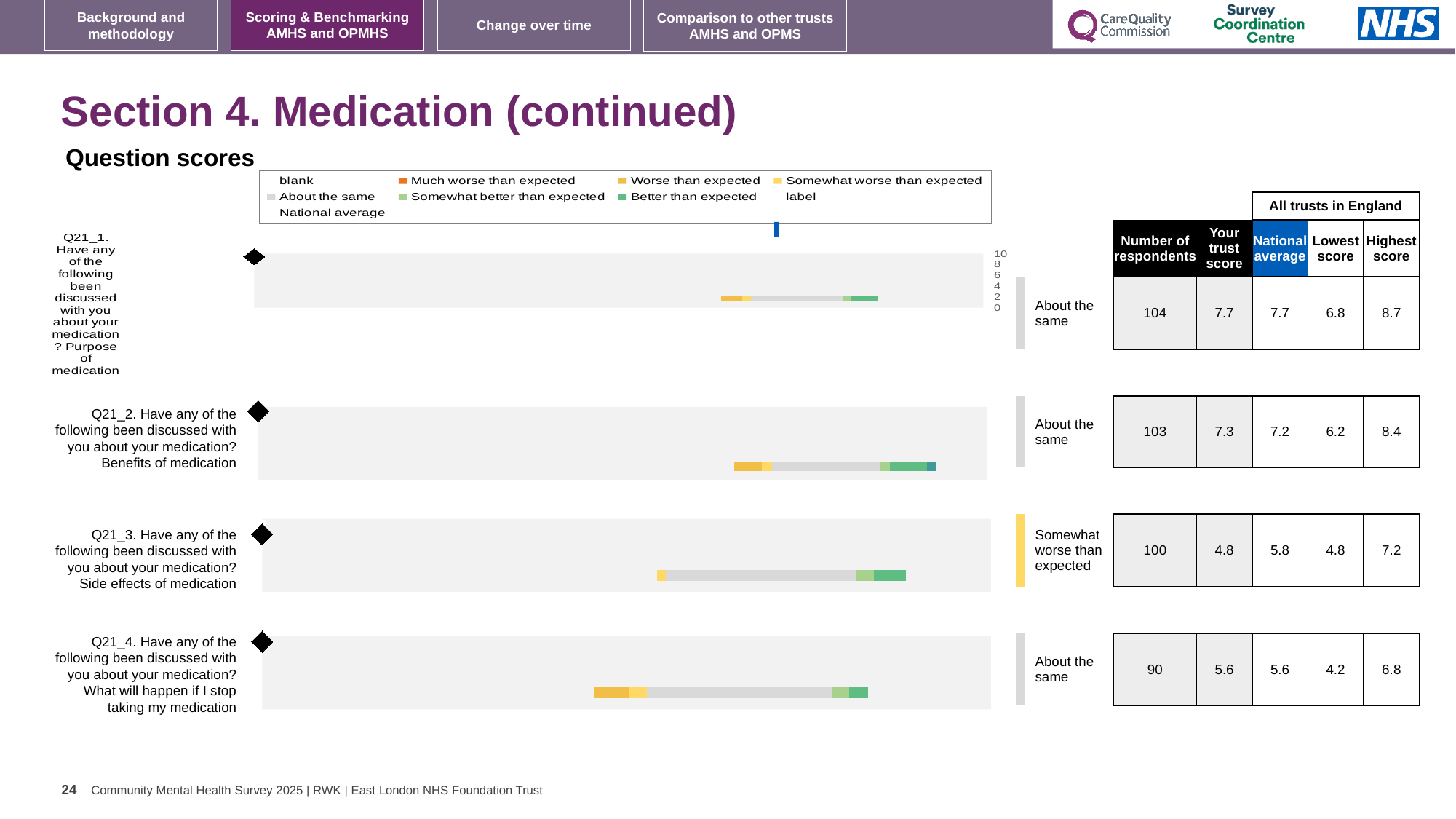
What benchmark category label is shown next to the chart for Q21_3 (Side effects of medication)? Somewhat worse than expected In the table beside the charts, what is the number of respondents for Q21_1 (Purpose of medication)? 104 For Q21_2 (Benefits of medication), which is larger: your trust score or the national average? Your trust score (7.3) In the legend, what colour represents "Better than expected"? green In the legend, what colour represents "Much worse than expected"? orange In the table beside the charts, what is "Your trust score" for Q21_3 (Side effects of medication)? 4.8 Which question has the highest "Your trust score" in the table? Q21_1 (7.7) How many question charts (rows) are shown on the slide? 4 What kind of chart is used to show the question scores on this slide? bar chart In the table beside the charts, what is the national average for Q21_4 (What will happen if I stop taking my medication)? 5.6 For Q21_3 (Side effects of medication), what is the difference between the highest score and the lowest score in the table? 2.4 How many entries does the legend above the charts list? 9